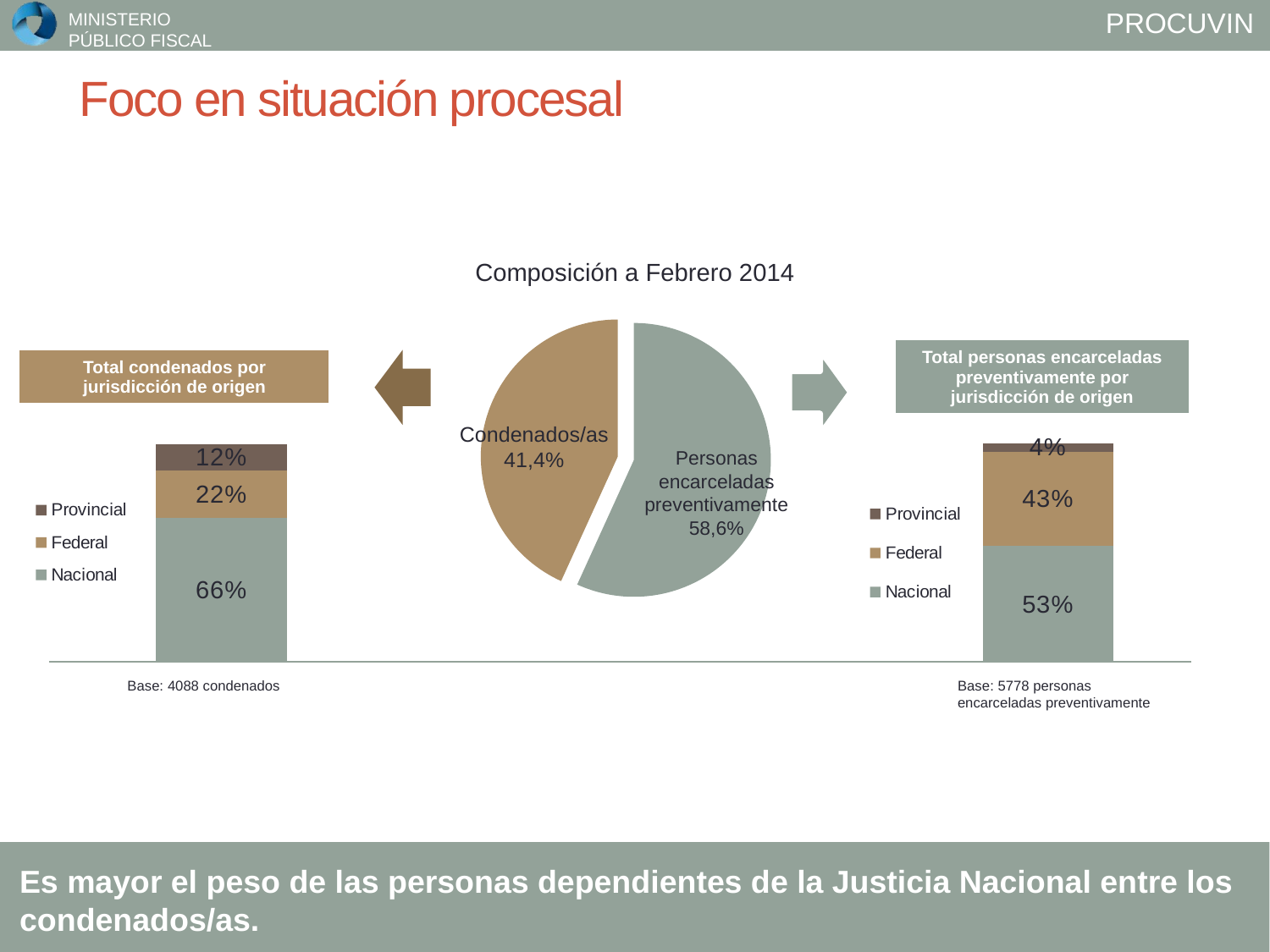
In the pie chart 'Composición a Febrero 2014', what share is labelled for Personas encarceladas preventivamente? 58,6% In the pie chart 'Composición a Febrero 2014', what share is labelled for Condenados/as? 41,4% In the pie chart 'Composición a Febrero 2014', which slice is larger? Personas encarceladas preventivamente In the right chart 'Total personas encarceladas preventivamente por jurisdicción de origen', which series has the smallest value? Provincial In the right chart 'Total personas encarceladas preventivamente por jurisdicción de origen', what is the difference between Nacional and Federal? 10% In the right chart 'Total personas encarceladas preventivamente por jurisdicción de origen', what is the value for Federal? 43% Which is larger: the Nacional value in the left chart 'Total condenados por jurisdicción de origen' or the Nacional value in the right chart 'Total personas encarceladas preventivamente por jurisdicción de origen'? Left chart (66%) How many slices does the pie chart 'Composición a Febrero 2014' have? 2 In the left chart 'Total condenados por jurisdicción de origen', what is the difference between Nacional and Federal? 44% In the left chart 'Total condenados por jurisdicción de origen', what is the value for Provincial? 12% How many series does the legend of the left chart 'Total condenados por jurisdicción de origen' list? 3 In the left chart 'Total condenados por jurisdicción de origen', what is the value for Nacional? 66%